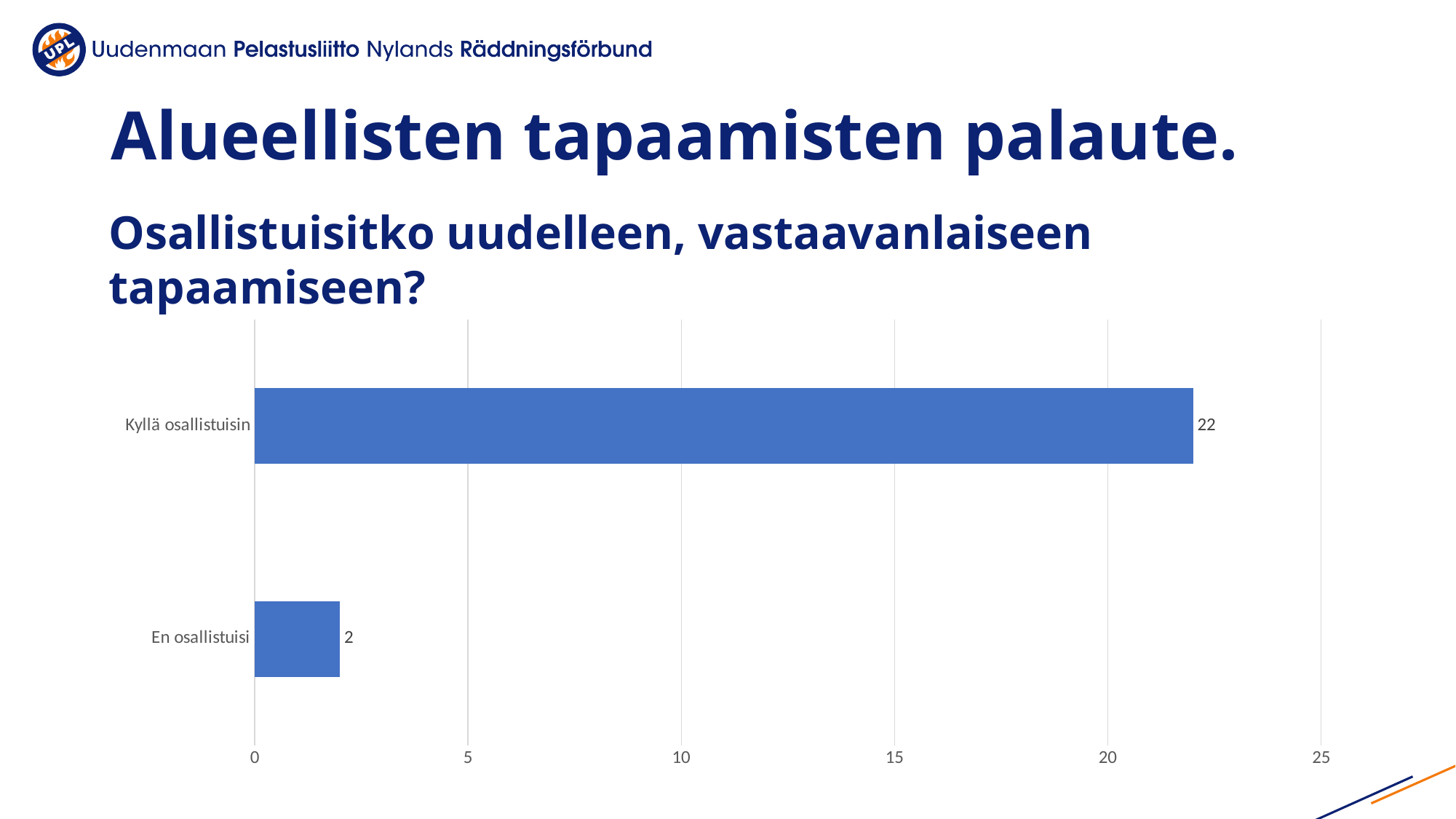
Which category has the lowest value? En osallistuisi Is the value for "En osallistuisi" greater or less than 5? less How many categories are shown in the chart? 2 What is the total of the two values shown in the chart? 24 What kind of chart is shown on the slide? Bar chart What is the value for "En osallistuisi"? 2 Which category has the highest value? Kyllä osallistuisin What is the highest value shown on the horizontal axis of the chart? 25 What is the value for "Kyllä osallistuisin"? 22 Which is larger, the value for "Kyllä osallistuisin" or the value for "En osallistuisi"? Kyllä osallistuisin Is the value for "Kyllä osallistuisin" greater or less than 20? greater What is the difference between the values for "Kyllä osallistuisin" and "En osallistuisi"? 20